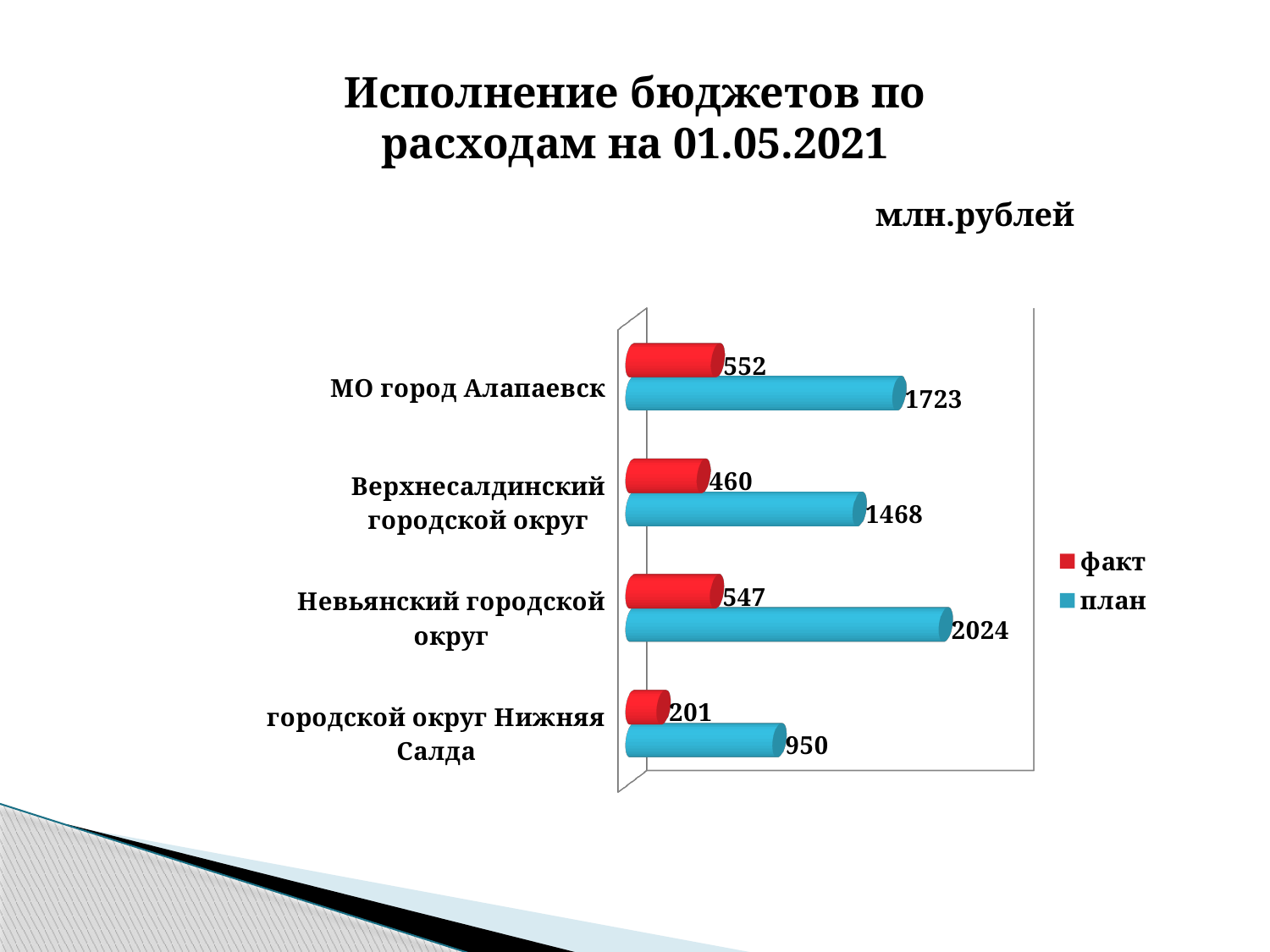
What is the факт value for Верхнесалдинский городской округ? 460 Which category has the lowest факт value? городской округ Нижняя Салда Which colour represents the план series? blue What unit is stated for the values on the chart? млн.рублей How many series does the legend list? 2 What is the difference between the план and факт values for Невьянский городской округ? 1477 What kind of chart is shown on the slide? bar chart What is the план value for МО город Алапаевск? 1723 Which is larger: the факт value for МО город Алапаевск or the факт value for Верхнесалдинский городской округ? МО город Алапаевск Which category has the highest план value? Невьянский городской округ What is the план value for городской округ Нижняя Салда? 950 How many categories are shown on the chart? 4